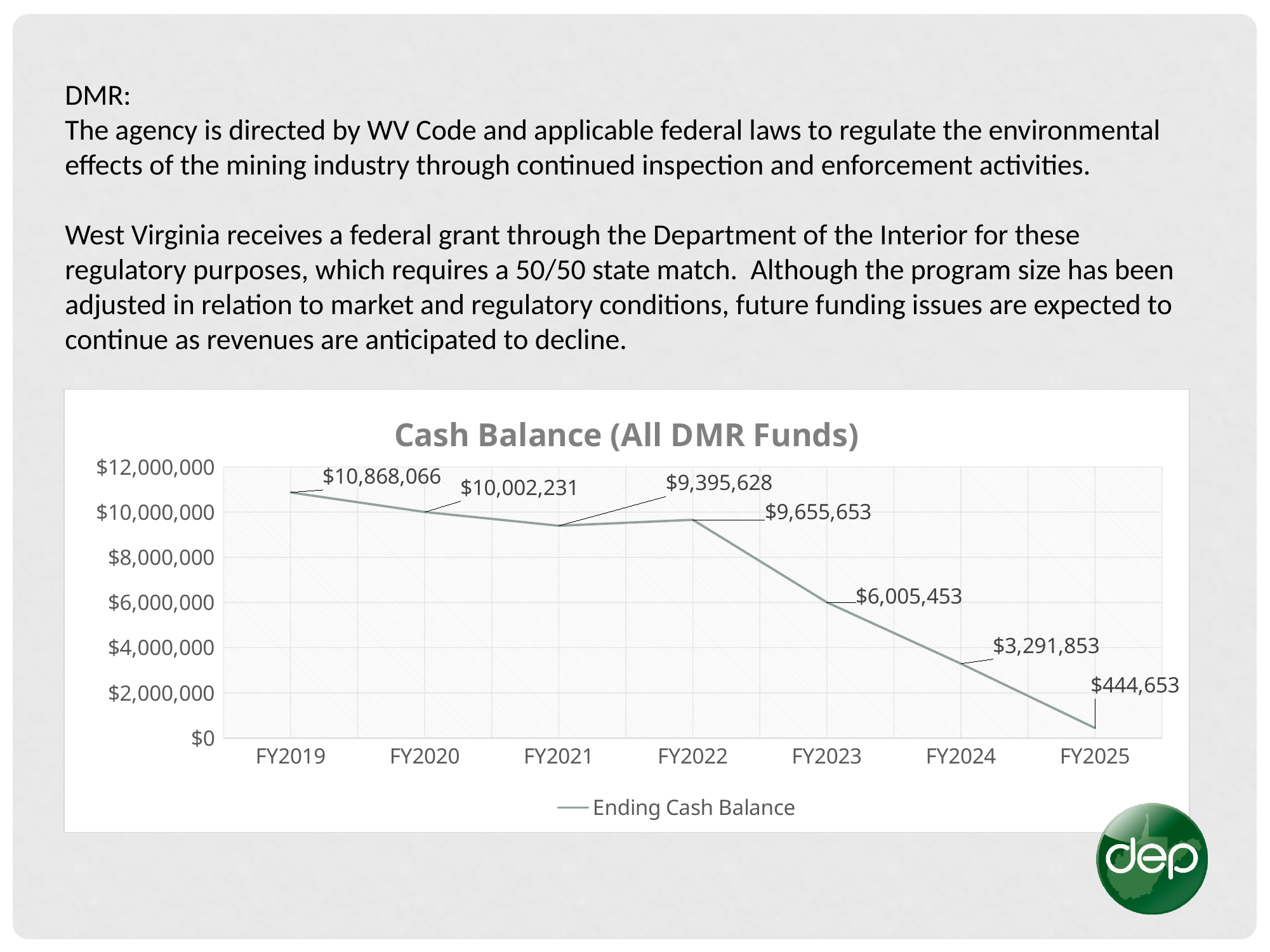
What is the Ending Cash Balance for FY2019? $10,868,066 Which is larger, the Ending Cash Balance in FY2021 or in FY2022? FY2022 Which fiscal year has the highest Ending Cash Balance? FY2019 What kind of chart is shown on the slide? line chart Is the Ending Cash Balance for FY2024 greater or less than $4,000,000? less What is the title of the chart? Cash Balance (All DMR Funds) What is the difference between the Ending Cash Balance in FY2023 and FY2024? $2,713,600 How many fiscal years are plotted on the chart? 7 Which fiscal year has the lowest Ending Cash Balance? FY2025 What is the Ending Cash Balance for FY2022? $9,655,653 What is the Ending Cash Balance for FY2025? $444,653 What is the difference between the Ending Cash Balance in FY2022 and FY2021? $260,025